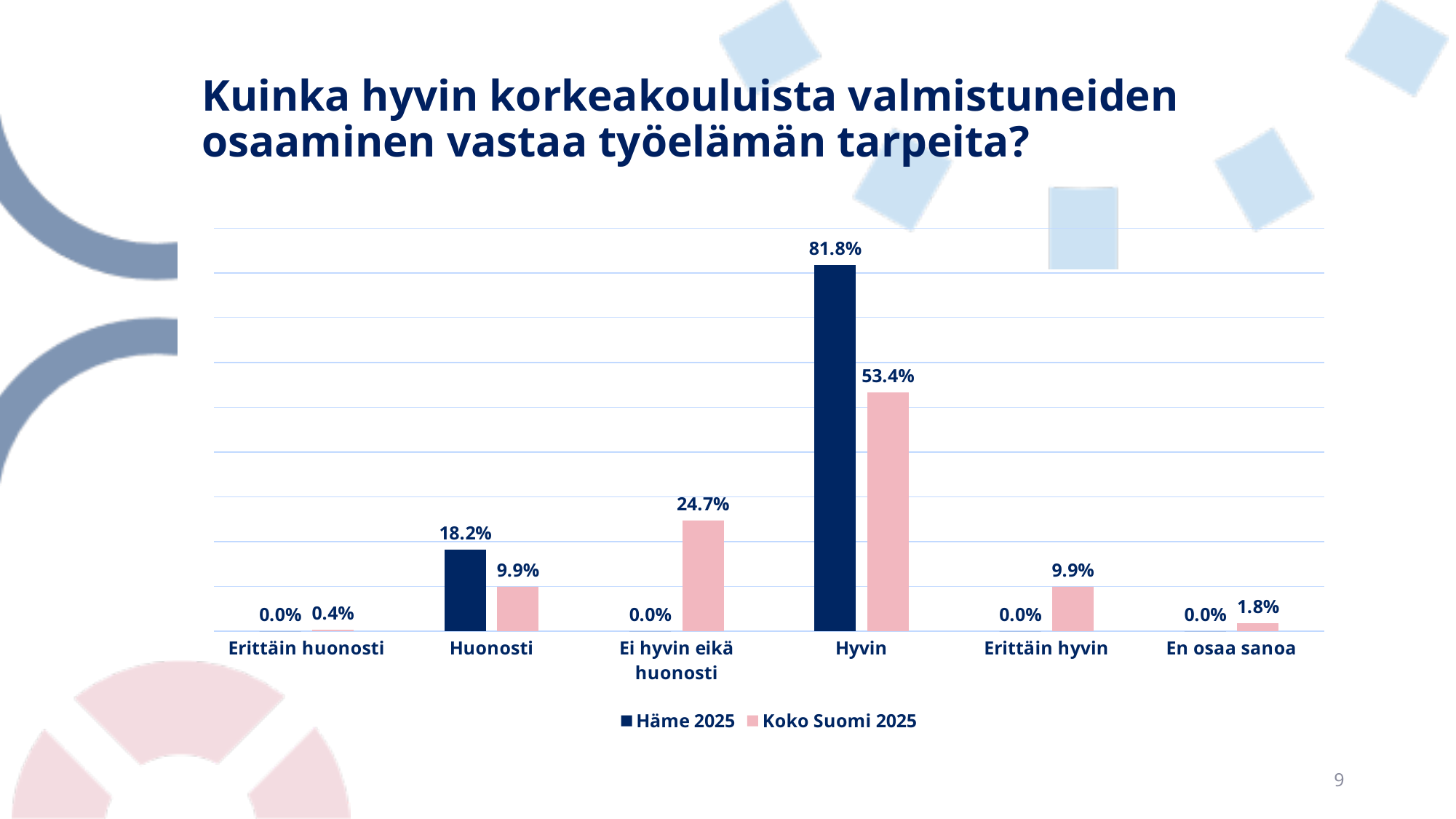
What is the value for Häme 2025 in the Huonosti category? 18.2% Which category has the lowest value for Koko Suomi 2025? Erittäin huonosti What kind of chart is shown on the slide? Bar chart How many categories are shown on the x axis? 6 What is the value for Koko Suomi 2025 in the Erittäin hyvin category? 9.9% What is the difference between Häme 2025 and Koko Suomi 2025 in the Hyvin category? 28.4% What is the value for Häme 2025 in the Hyvin category? 81.8% How many series does the legend list? 2 Which series is shown in dark blue? Häme 2025 In the Huonosti category, which series has the larger value, Häme 2025 or Koko Suomi 2025? Häme 2025 What is the value for Koko Suomi 2025 in the Ei hyvin eikä huonosti category? 24.7% Which category has the highest value for Koko Suomi 2025? Hyvin